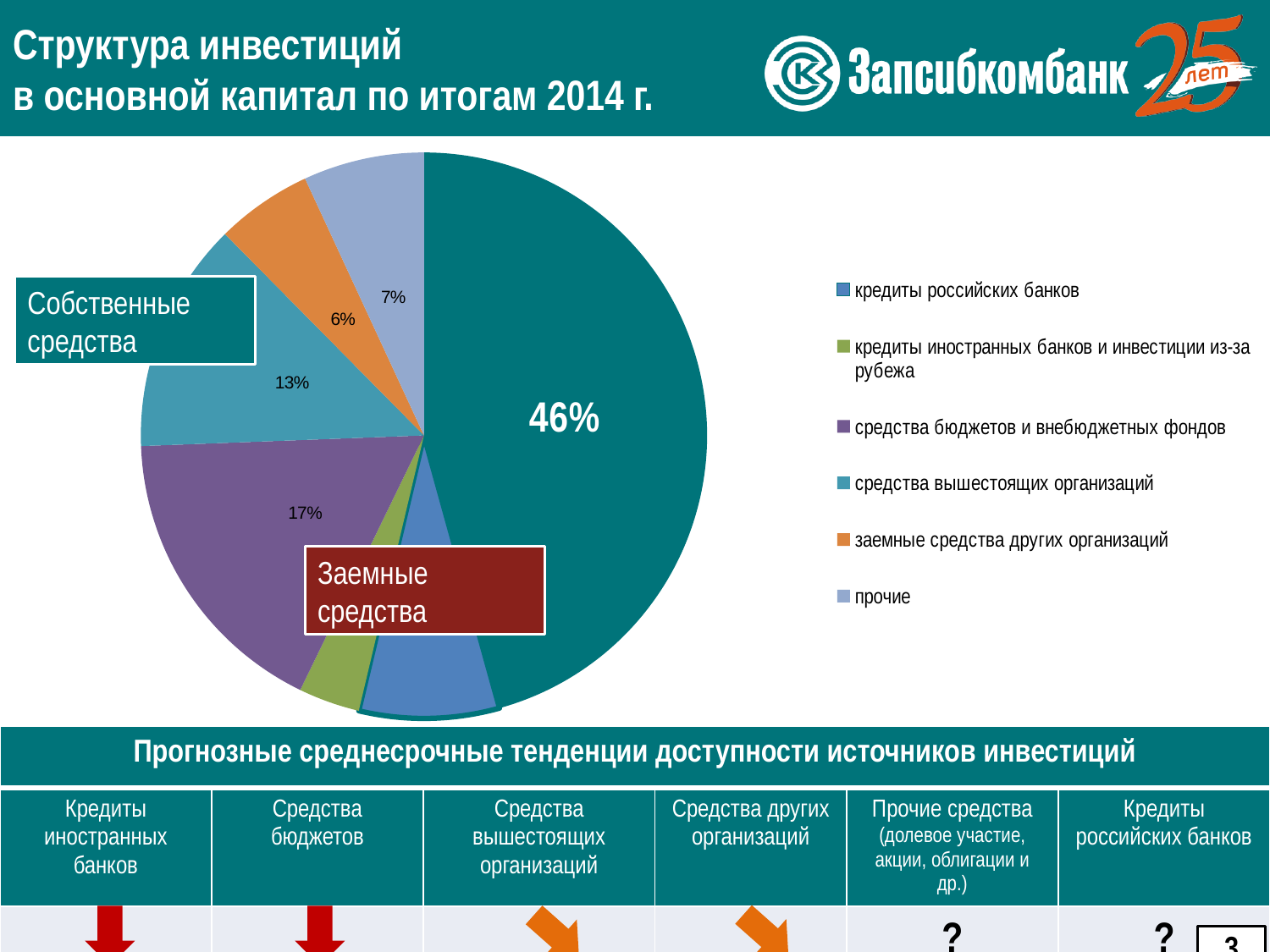
What is the difference between the shares of 'средства бюджетов и внебюджетных фондов' and 'средства вышестоящих организаций'? 4 percentage points What is the difference between the largest slice (46%) and the 'средства бюджетов и внебюджетных фондов' slice? 29 percentage points What is the title of the chart on the slide? Структура инвестиций в основной капитал по итогам 2014 г. How many slices does the pie chart have? 7 Which is larger in the pie chart: 'прочие' or 'заемные средства других организаций'? прочие What share does 'заемные средства других организаций' have in the pie chart? 6% How many entries does the chart legend list? 6 What type of chart is shown on the slide? Pie chart What is the value of the largest slice of the pie chart? 46% What share does 'прочие' have in the pie chart? 7% What share does 'средства бюджетов и внебюджетных фондов' have in the pie chart? 17% What share does 'средства вышестоящих организаций' have in the pie chart? 13%